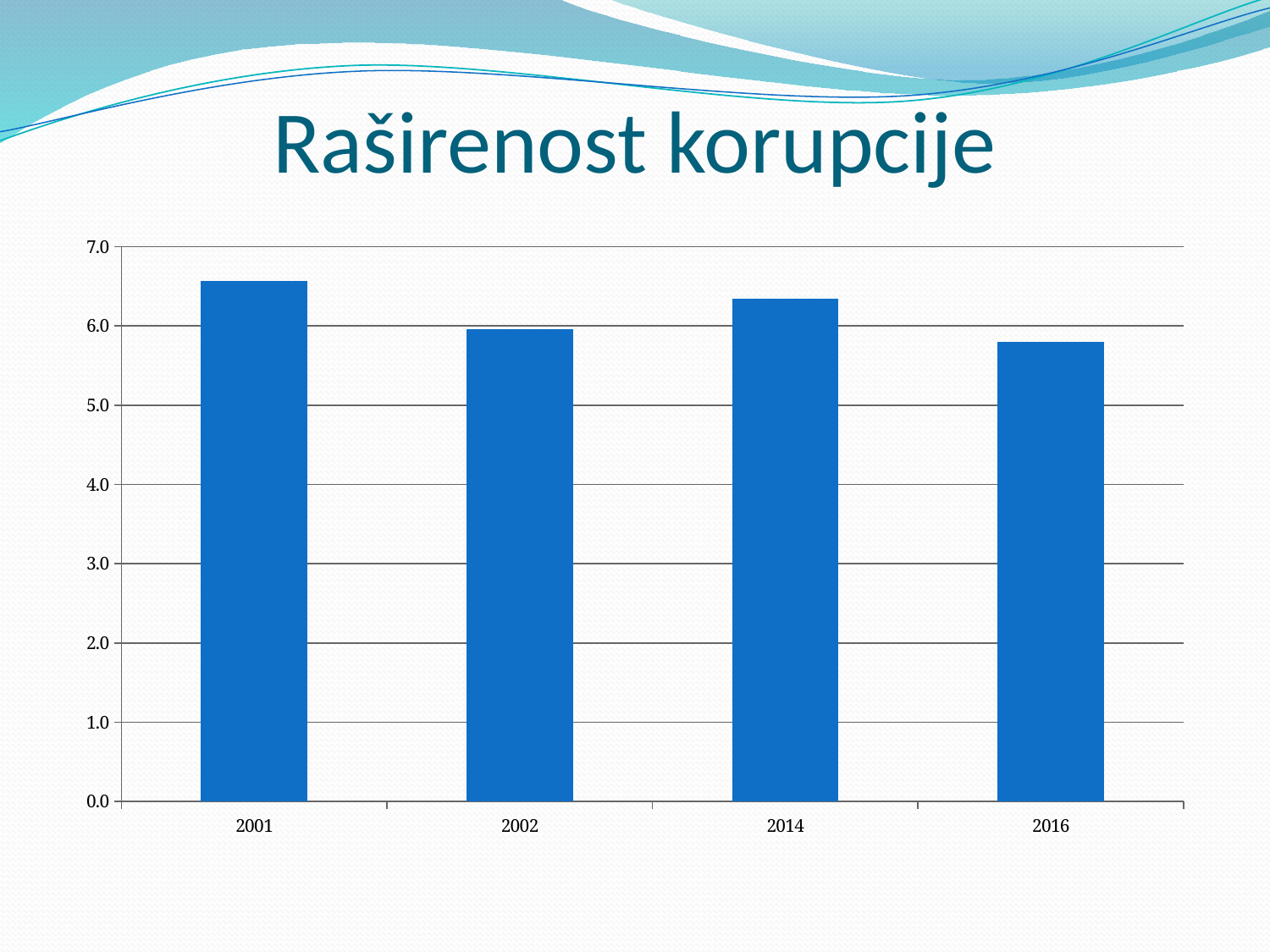
How many years are shown on the x axis of the chart? 4 Which year has the highest bar in the chart? 2001 What is the highest value shown on the y axis of the chart? 7.0 Is the value for 2016 greater or less than 6.0? less What is the title of the chart? Raširenost korupcije Is the value for 2002 greater or less than 5.0? greater Is the value for 2001 greater or less than 6.0? greater Which year has the lowest bar in the chart? 2016 Which is larger, the value for 2002 or the value for 2016? 2002 What kind of chart is shown on the slide? bar chart Which is larger, the value for 2001 or the value for 2014? 2001